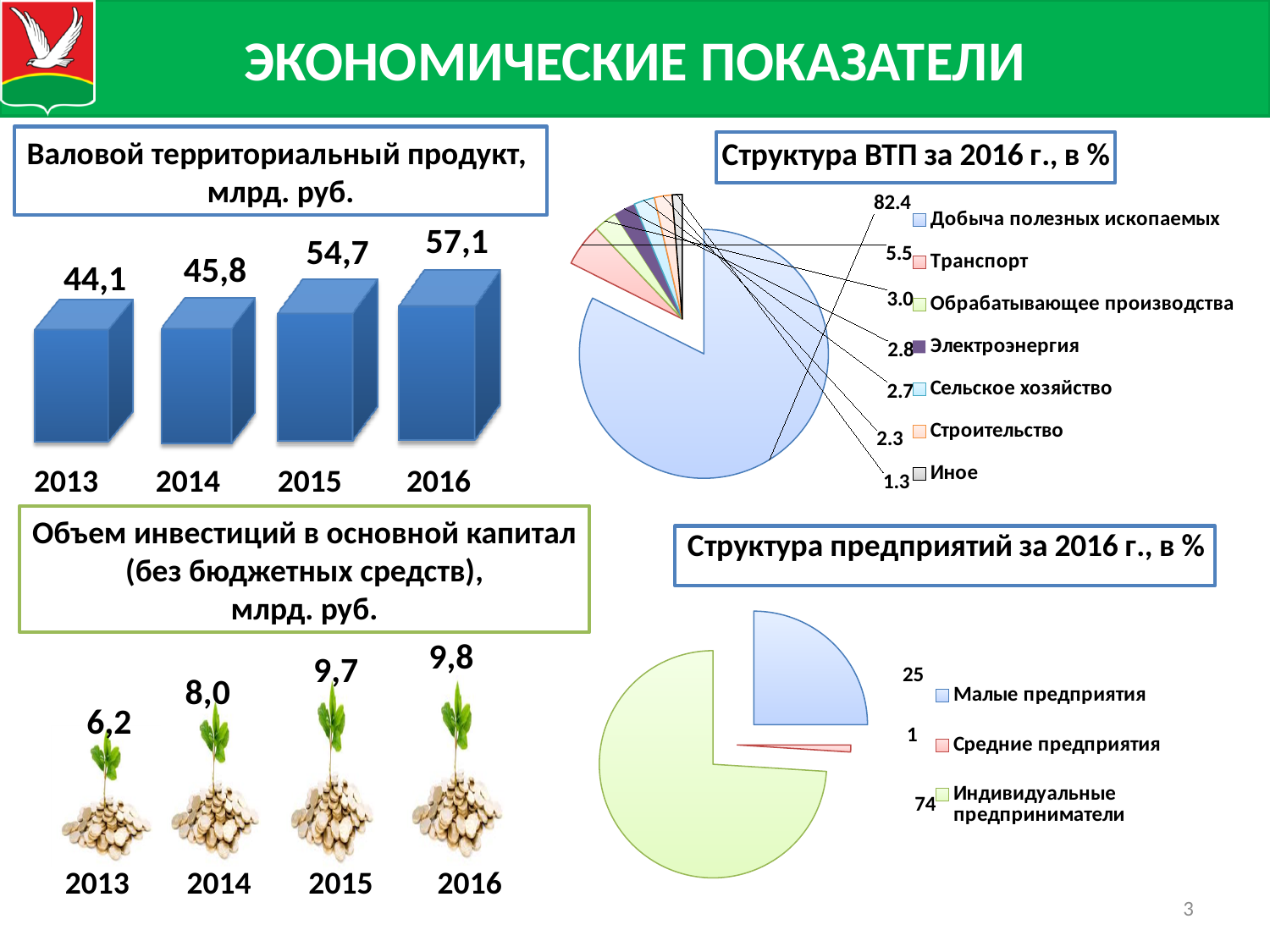
On the chart 'Объем инвестиций в основной капитал (без бюджетных средств), млрд. руб.', what is the value for 2014? 8,0 How many categories does the legend of the pie chart 'Структура ВТП за 2016 г., в %' list? 7 What kind of chart is 'Валовой территориальный продукт, млрд. руб.'? bar chart On the pie chart 'Структура ВТП за 2016 г., в %', what is the share for Транспорт? 5.5 On the chart 'Валовой территориальный продукт, млрд. руб.', what is the difference between the 2015 and 2014 values? 8,9 On the pie chart 'Структура ВТП за 2016 г., в %', which is larger: Электроэнергия or Строительство? Электроэнергия On the chart 'Валовой территориальный продукт, млрд. руб.', do the values rise or fall from 2013 to 2016? rise On the chart 'Валовой территориальный продукт, млрд. руб.', which year has the lowest value? 2013 On the pie chart 'Структура предприятий за 2016 г., в %', what is the share for Индивидуальные предприниматели? 74 On the chart 'Валовой территориальный продукт, млрд. руб.', what is the value for 2016? 57,1 On the chart 'Объем инвестиций в основной капитал (без бюджетных средств), млрд. руб.', what is the difference between the 2016 and 2013 values? 3,6 On the pie chart 'Структура ВТП за 2016 г., в %', which category has the largest share? Добыча полезных ископаемых